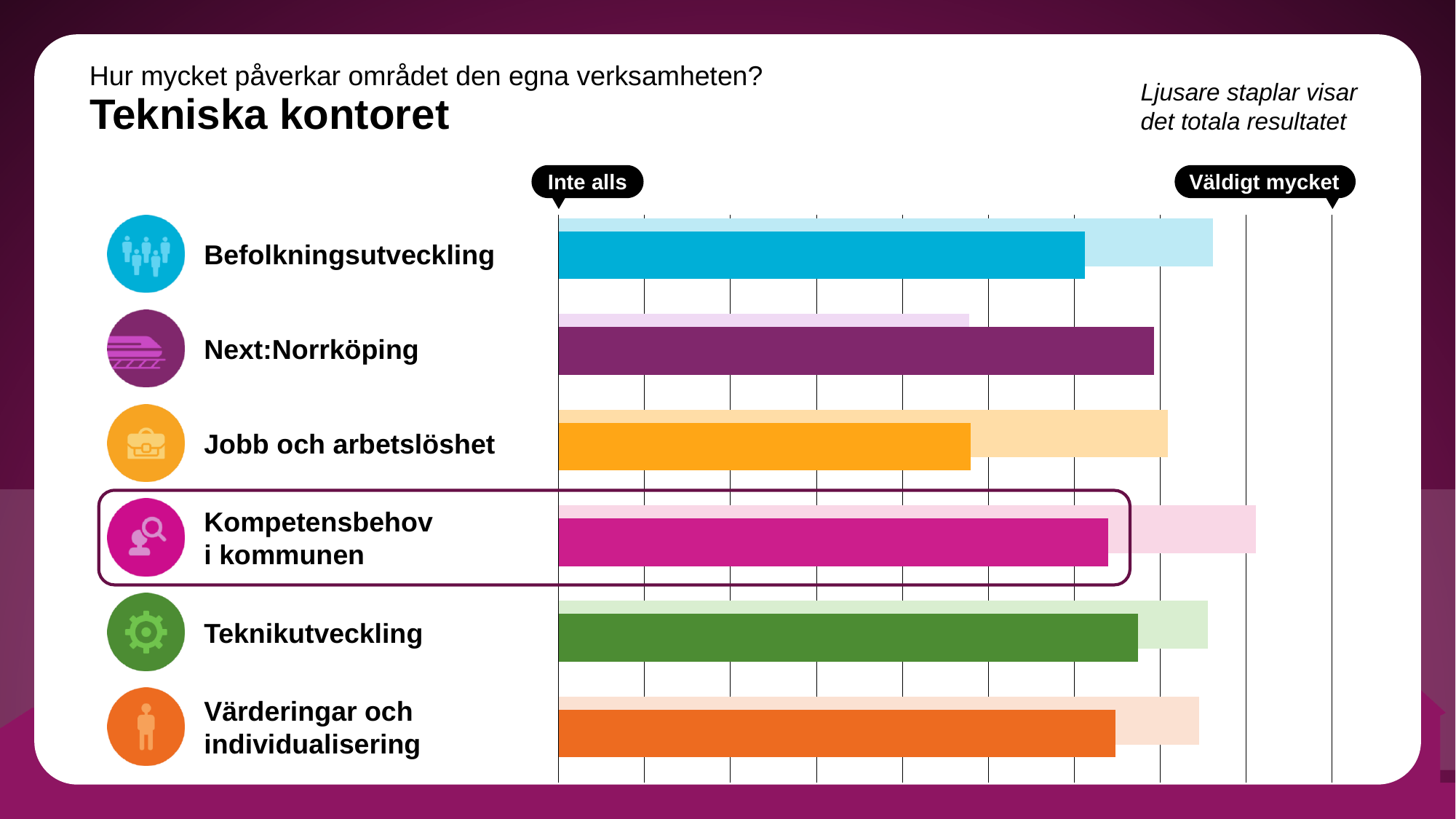
Which category has the shortest dark bar (Tekniska kontoret result)? Jobb och arbetslöshet Which dark bar is longer: Kompetensbehov i kommunen or Jobb och arbetslöshet? Kompetensbehov i kommunen For Next:Norrköping, which bar is longer: the dark bar or the light bar? The dark bar For Befolkningsutveckling, which bar is longer: the dark bar or the light bar? The light bar What kind of chart is shown on the slide? Bar chart What are the labels at the left and right ends of the chart's axis? Inte alls and Väldigt mycket How many categories (areas) are shown in the chart? 6 What is the title of the chart on the slide? Tekniska kontoret Which category has the shortest light bar (total result)? Next:Norrköping Which category has the longest light bar (total result)? Kompetensbehov i kommunen